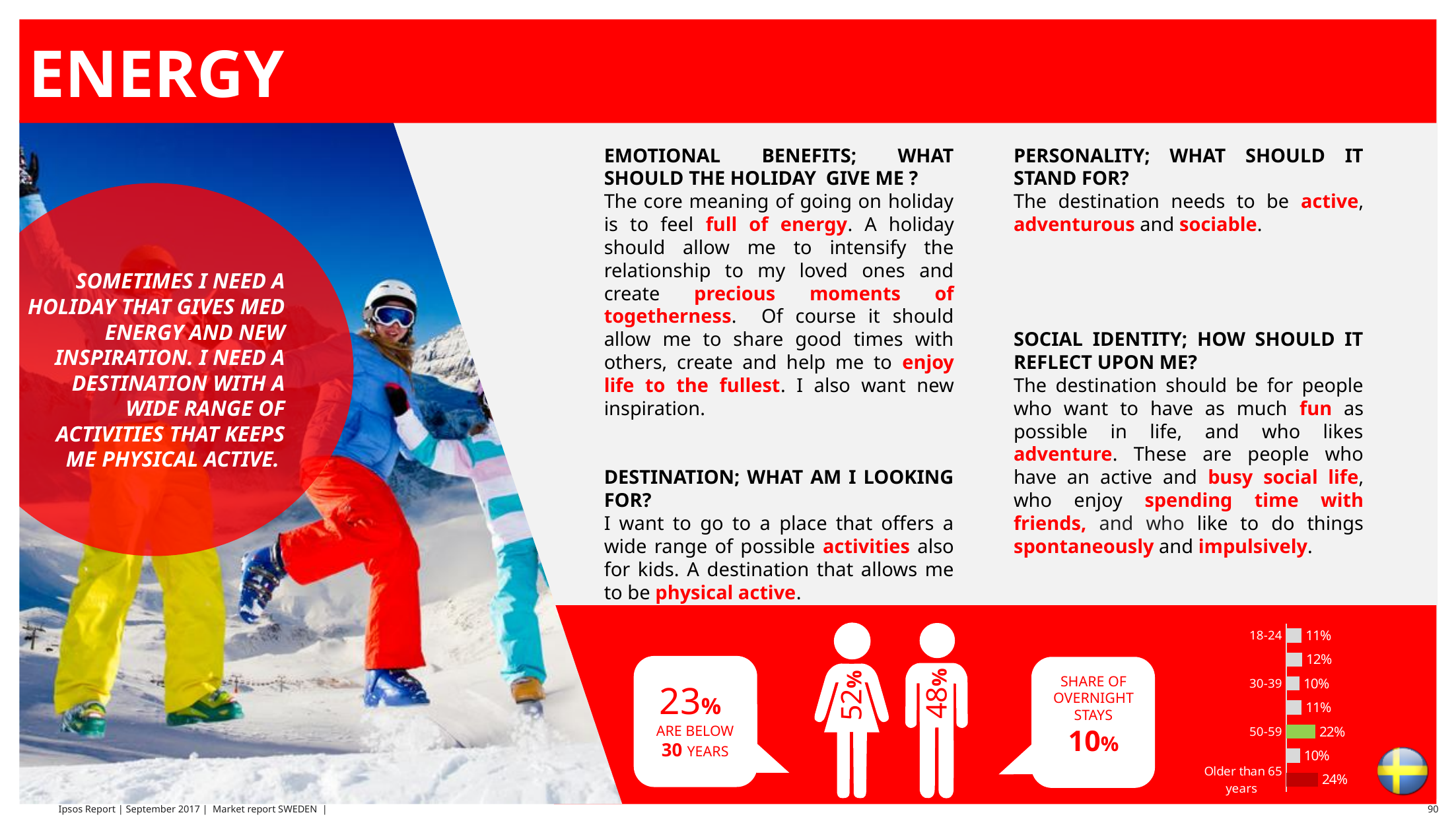
How many bars are plotted in the age-group chart at the bottom right? 7 What kind of chart is the age-group chart at the bottom right of the slide? Bar chart In the bar chart at the bottom right, what is the difference between the value for 'Older than 65 years' and the value for 50-59? 2 percentage points What is the value for the 50-59 age group in the bar chart at the bottom right? 22% Which labelled age group has the highest value in the bar chart at the bottom right? Older than 65 years What is the value for the 30-39 age group in the bar chart at the bottom right? 10% What is the value for the 18-24 age group in the bar chart at the bottom right? 11% What is the value for the 'Older than 65 years' group in the bar chart at the bottom right? 24% In the bar chart at the bottom right, which is larger: the value for 'Older than 65 years' or the value for 30-39? Older than 65 years In the bar chart at the bottom right, which is larger: the value for 50-59 or the value for 18-24? 50-59 In the bar chart at the bottom right, what is the difference between the value for 50-59 and the value for 18-24? 11 percentage points In the bar chart at the bottom right, what colour is the bar for the 50-59 age group? Green